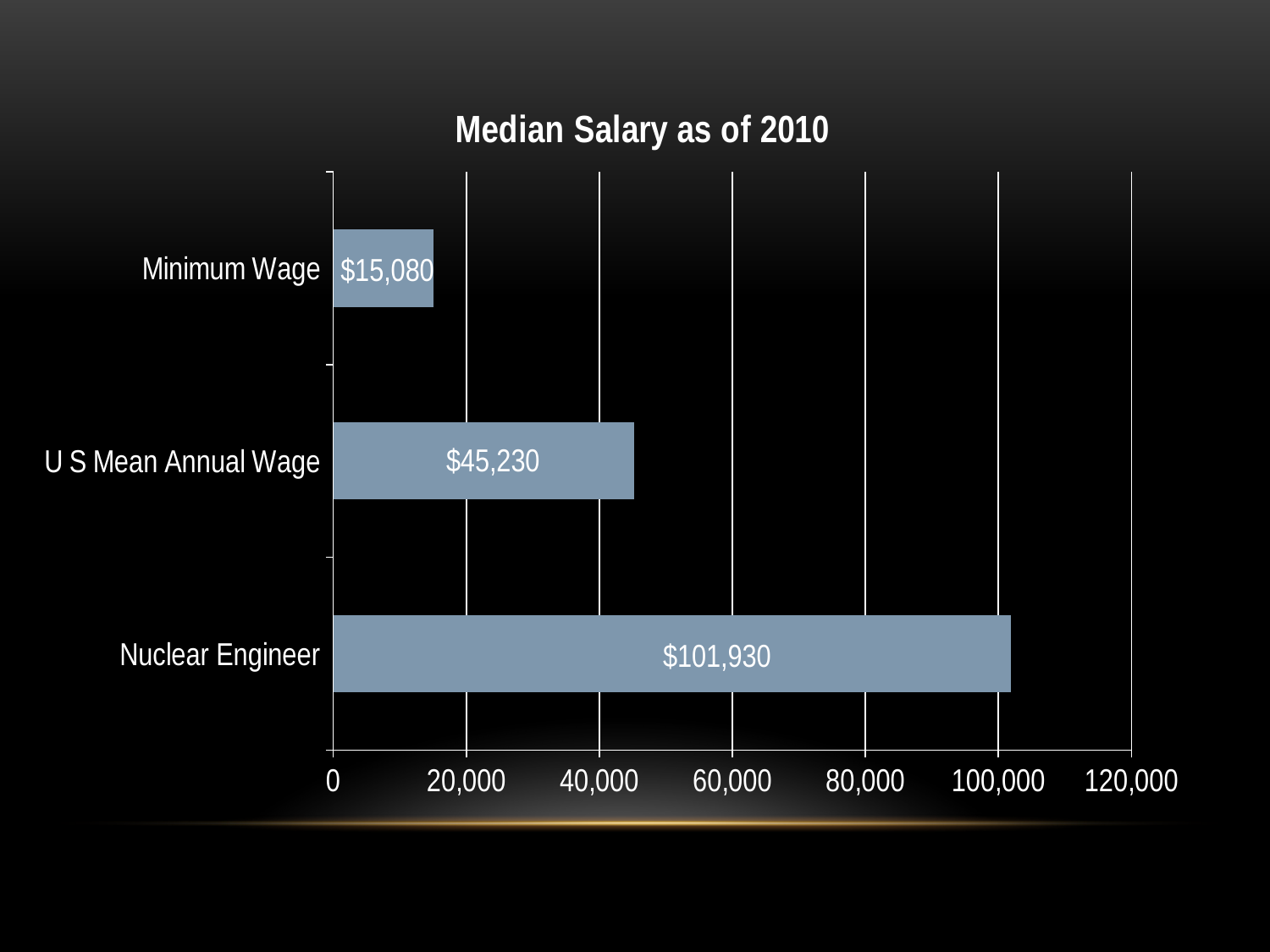
How many categories are shown in the chart? 3 What is the value shown for U S Mean Annual Wage? $45,230 What is the difference between the U S Mean Annual Wage value and the Minimum Wage value? $30,150 What is the median salary shown for Nuclear Engineer? $101,930 Is the value for Nuclear Engineer greater or less than 100,000? greater What kind of chart is shown on the slide? Bar chart Which is larger, the value for U S Mean Annual Wage or the value for Minimum Wage? U S Mean Annual Wage What is the title of the chart? Median Salary as of 2010 Which category has the highest value? Nuclear Engineer What is the value shown for Minimum Wage? $15,080 What is the difference between the Nuclear Engineer value and the U S Mean Annual Wage value? $56,700 Which category has the lowest value? Minimum Wage